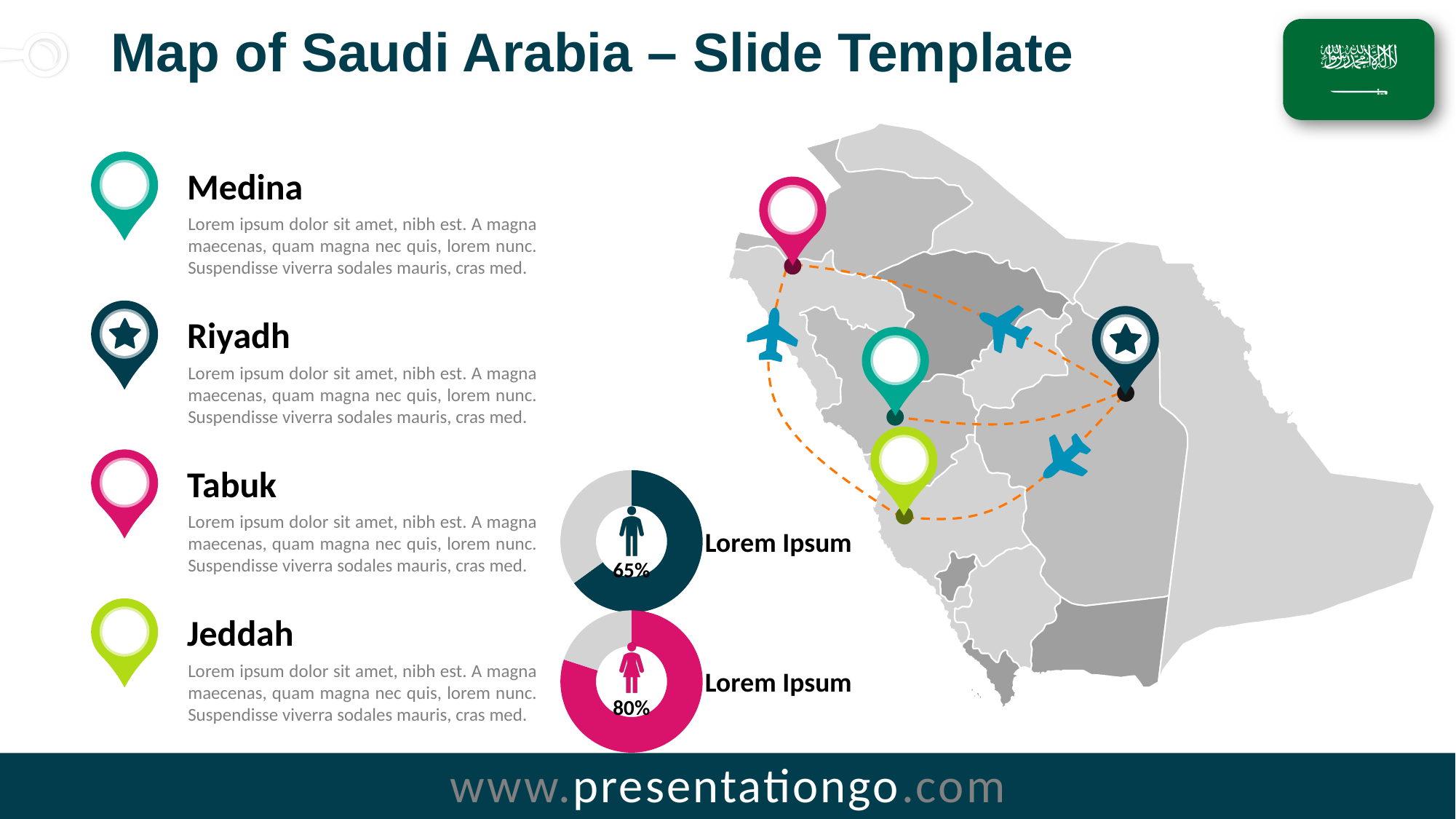
How many donut charts are shown on the slide? 2 What value is shown in the top donut chart with the male figure icon? 65% What is the difference between the value in the bottom donut chart (80%) and the top donut chart (65%)? 15% What kind of chart is used to display the 65% and 80% values? Donut chart Is the value in the top donut chart (male icon) greater or less than 50%? greater What value is shown in the bottom donut chart with the female figure icon? 80% Which donut chart shows the larger value, the top one (male icon) or the bottom one (female icon)? The bottom one (female icon) Is the value in the bottom donut chart (female icon) greater or less than 75%? greater What colour is the filled portion of the bottom donut chart showing 80%? Magenta (pink) What label appears to the right of each donut chart? Lorem Ipsum What share of the top donut chart is not filled, given the filled portion is 65%? 35%